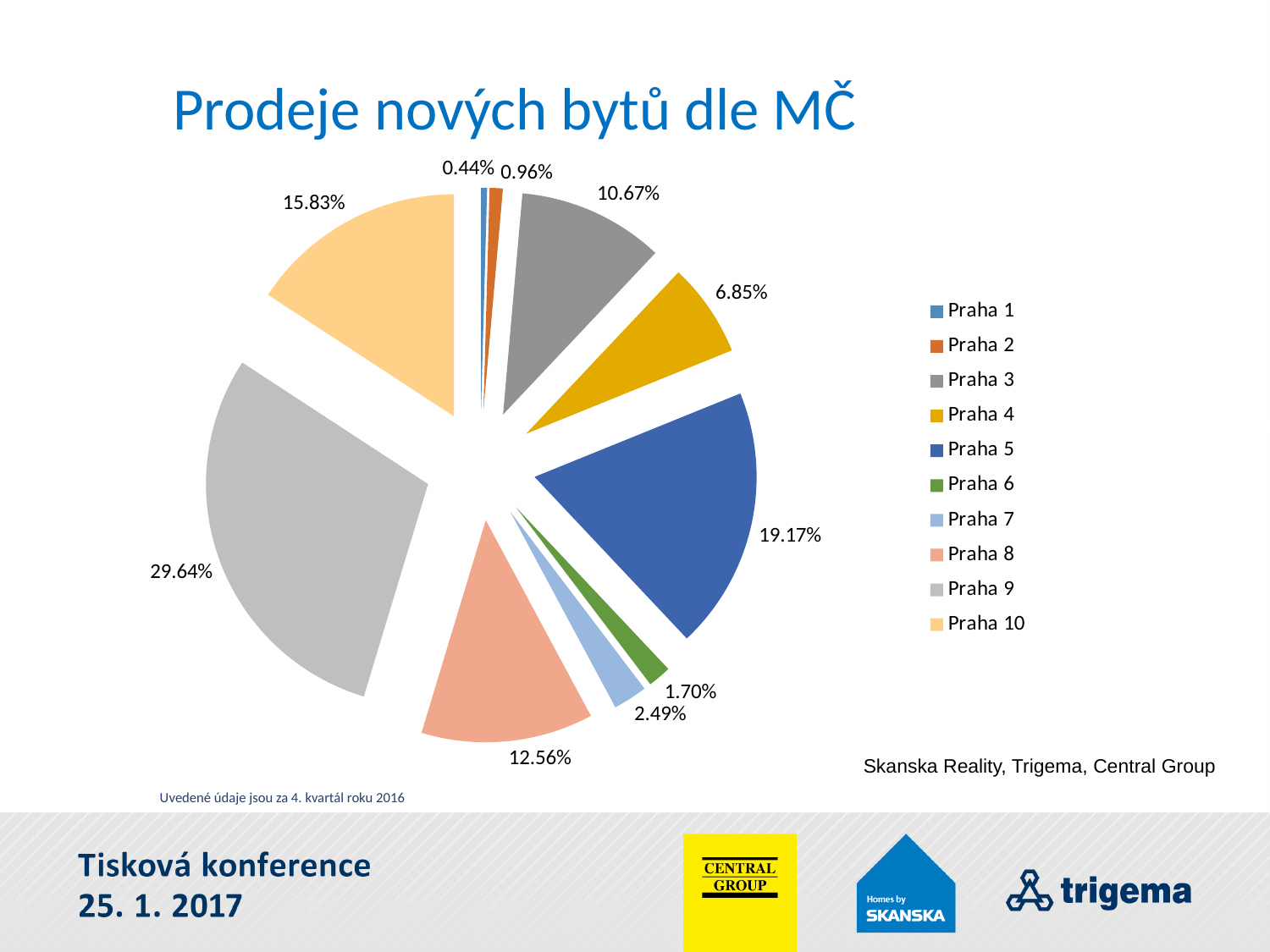
What is the share for Praha 10? 15.83% What kind of chart is shown on the slide? pie chart What is the share for Praha 1? 0.44% What is the title of the chart? Prodeje nových bytů dle MČ What is the difference in percentage points between Praha 9 and Praha 5? 10.47 Which has a larger share, Praha 8 or Praha 4? Praha 8 What is the share for Praha 9? 29.64% Which district has the largest share of new flat sales? Praha 9 Which district has the smallest share of new flat sales? Praha 1 How many districts are listed in the legend? 10 What is the share for Praha 5? 19.17% What is the share for Praha 3? 10.67%